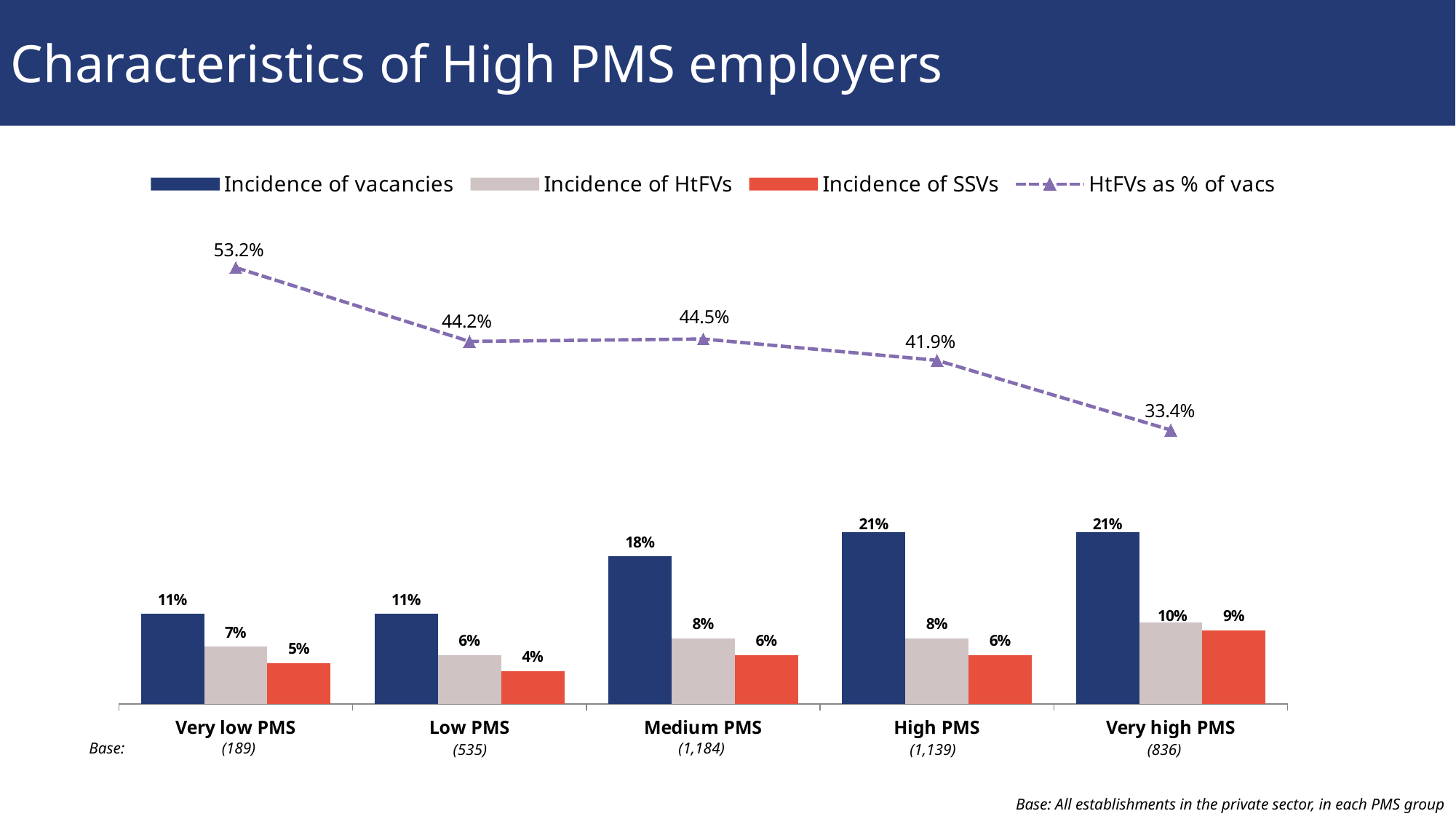
What kind of chart is this? Combined bar and line chart Which PMS group has the highest Incidence of HtFVs? Very high PMS What is the difference in HtFVs as % of vacs between Very low PMS and Very high PMS? 19.8 percentage points What is the HtFVs as % of vacs value for Very low PMS? 53.2% Does the HtFVs as % of vacs line generally rise or fall from Very low PMS to Very high PMS? Fall How many series does the legend list? 4 What is the Incidence of vacancies for Medium PMS? 18% Which is larger: the Incidence of SSVs for Low PMS or for High PMS? High PMS What is the Incidence of SSVs for Very high PMS? 9% Which PMS group has the lowest HtFVs as % of vacs? Very high PMS What is the Incidence of HtFVs for Low PMS? 6% How many PMS groups are shown on the x axis? 5